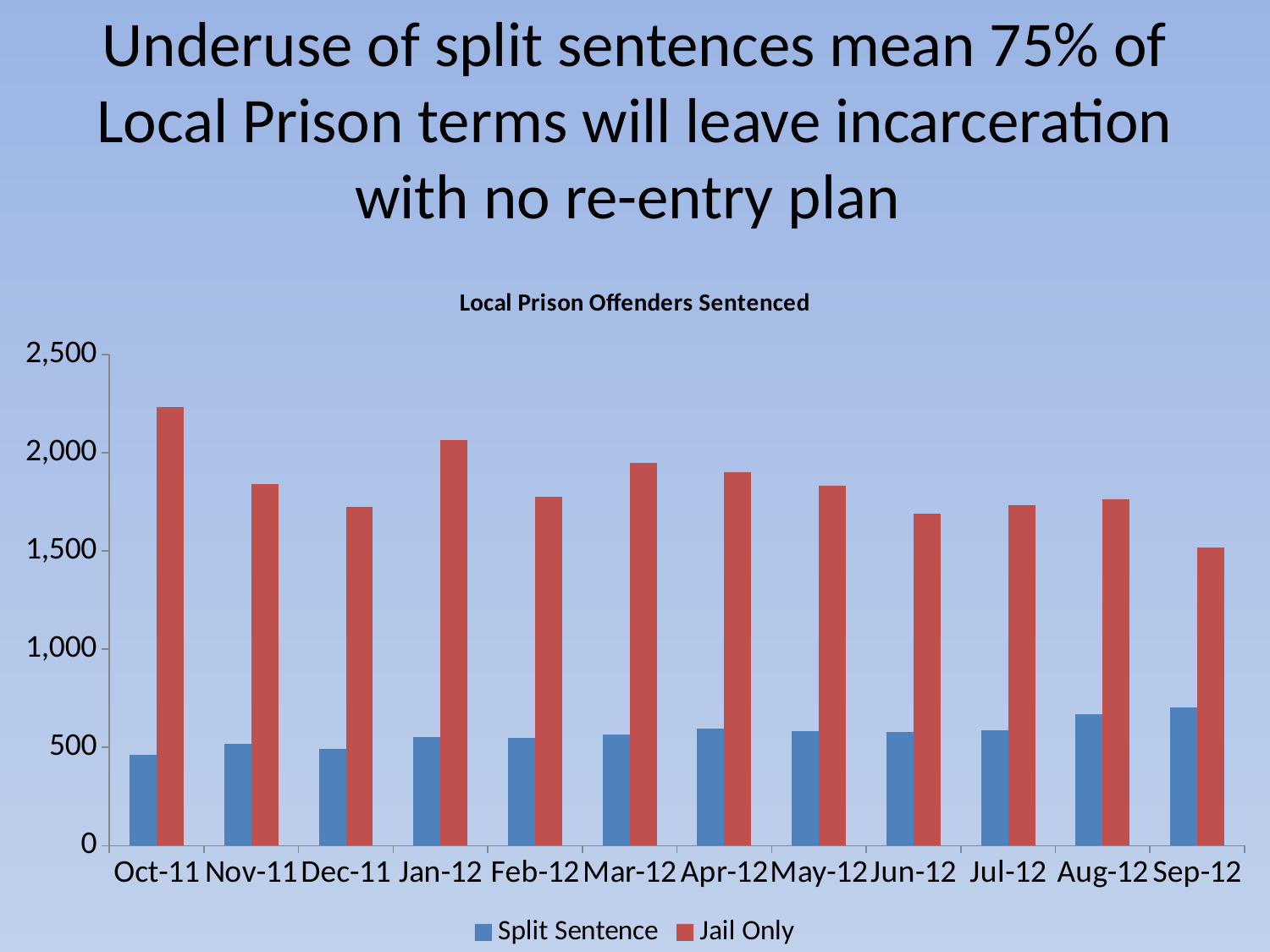
What is the title of the chart? Local Prison Offenders Sentenced What kind of chart is shown on the slide? bar chart Is the Jail Only value for Jun-12 greater or less than 2,000? less How many series does the legend list? 2 Which is larger in Sep-12, the Split Sentence value or the Jail Only value? Jail Only How many months are shown on the x axis? 12 Is the Split Sentence value for Oct-11 greater or less than 500? less Do the Split Sentence values generally rise or fall from Oct-11 to Sep-12? rise In which month is the Jail Only value lowest? Sep-12 In which month is the Jail Only value highest? Oct-11 Is the Jail Only value for Oct-11 greater or less than 2,000? greater In which month is the Split Sentence value highest? Sep-12